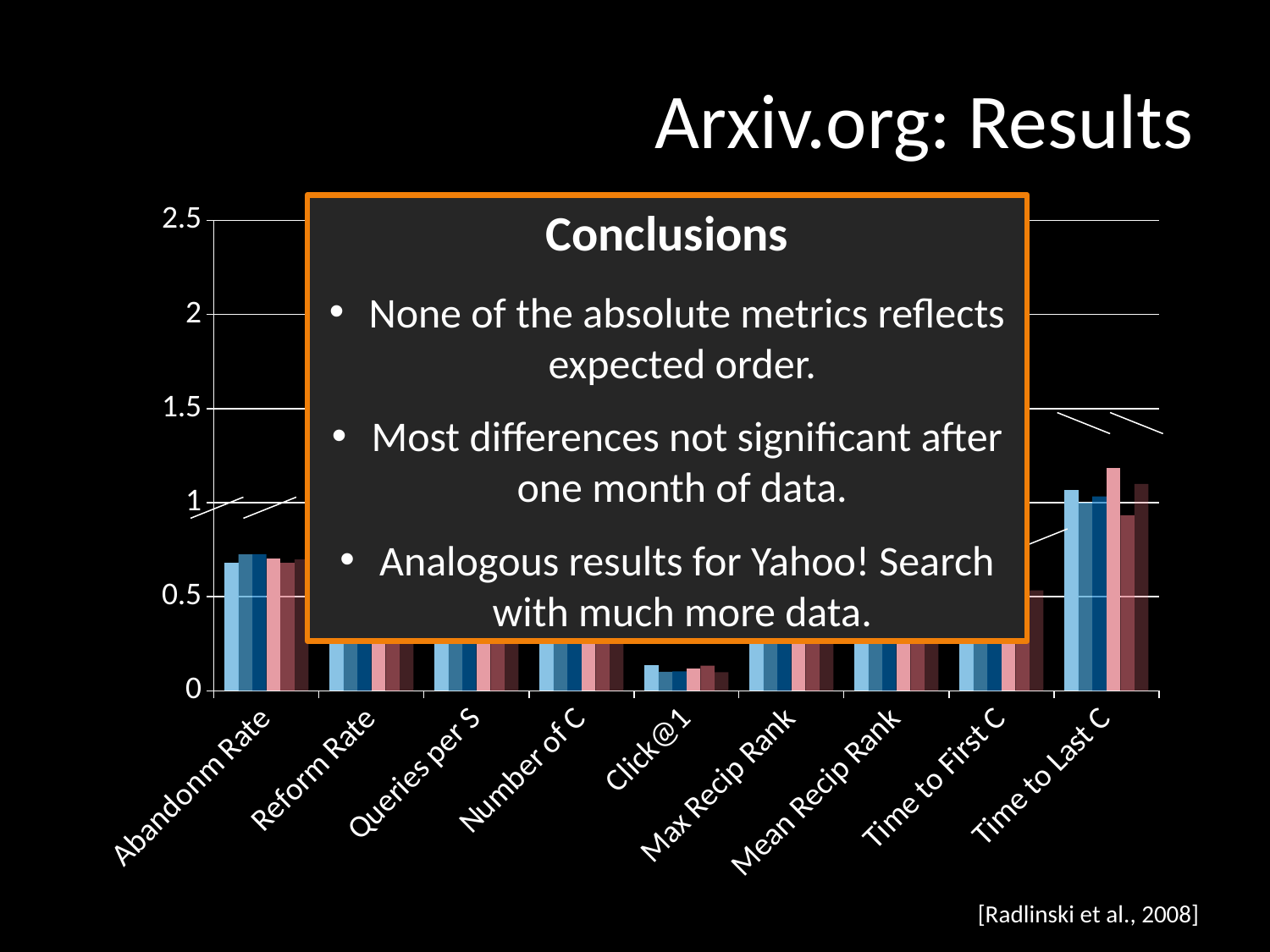
Which category has larger bars, Time to Last C or Click@1? Time to Last C What kind of chart is shown on the slide? bar chart What is the title of the slide containing the chart? Arxiv.org: Results What is the highest value shown on the y axis of the chart? 2.5 Are the bars for Click@1 greater or less than 0.5? less How many bars are plotted for each category in the chart? 6 Are the bars for Abandonm Rate greater or less than 1? less How many categories are labelled on the x axis of the chart? 9 Are the bars for Abandonm Rate greater or less than 0.5? greater Which category has the lowest bars in the chart? Click@1 Which category has larger bars, Abandonm Rate or Click@1? Abandonm Rate